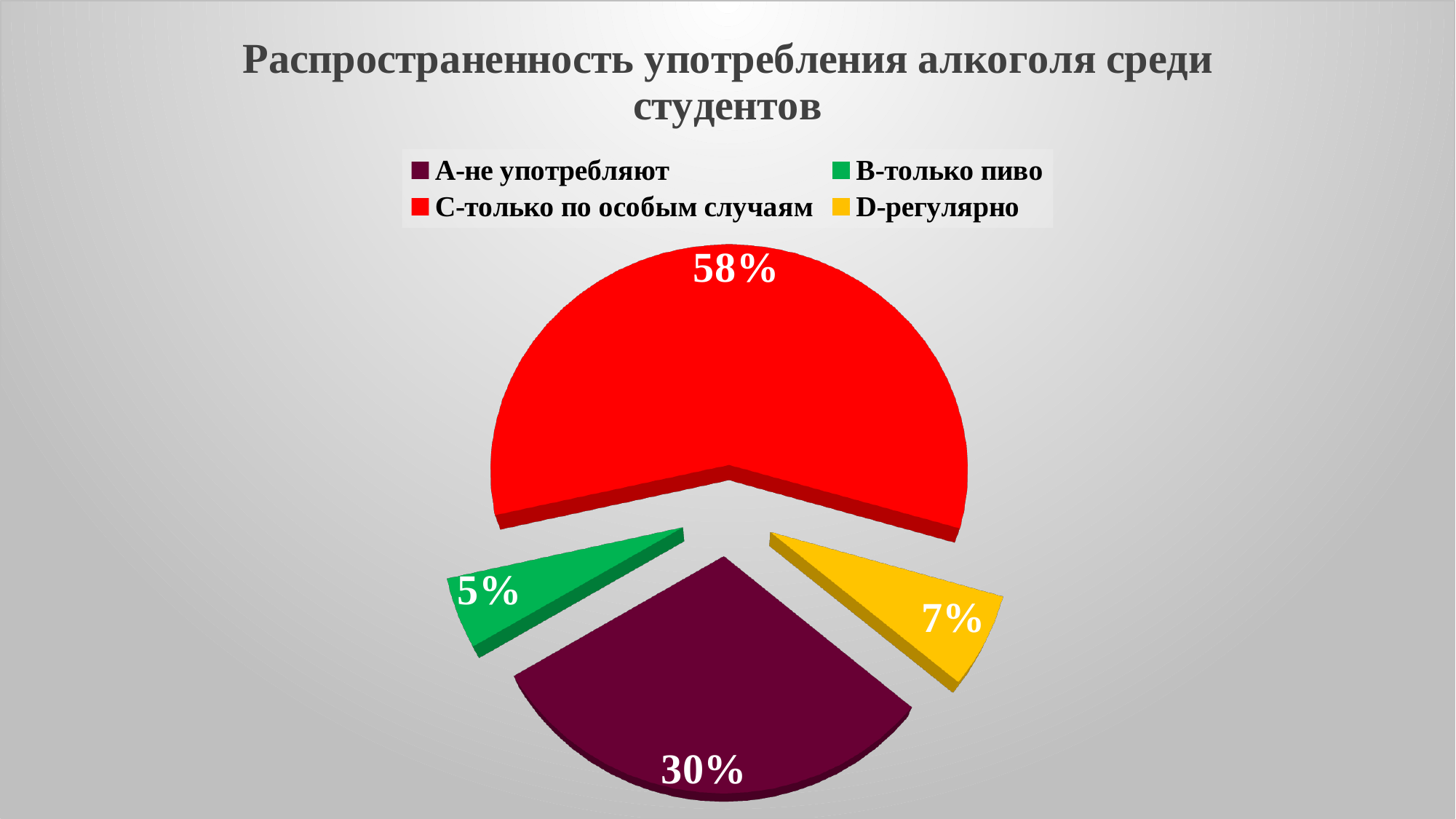
What colour is the slice for "D-регулярно"? Yellow What is the difference in percentage points between "C-только по особым случаям" and "A-не употребляют"? 28 Which is larger, the share for "D-регулярно" or the share for "B-только пиво"? D-регулярно What percentage of students is shown for "A-не употребляют"? 30% Which category has the smallest share of the pie? B-только пиво How many categories does the pie chart show? 4 What percentage of students is shown for "D-регулярно"? 7% What is the title of the chart? Распространенность употребления алкоголя среди студентов Which category has the largest share of the pie? C-только по особым случаям What type of chart is shown on the slide? Pie chart What percentage of students is shown for "C-только по особым случаям"? 58% What percentage of students is shown for "B-только пиво"? 5%